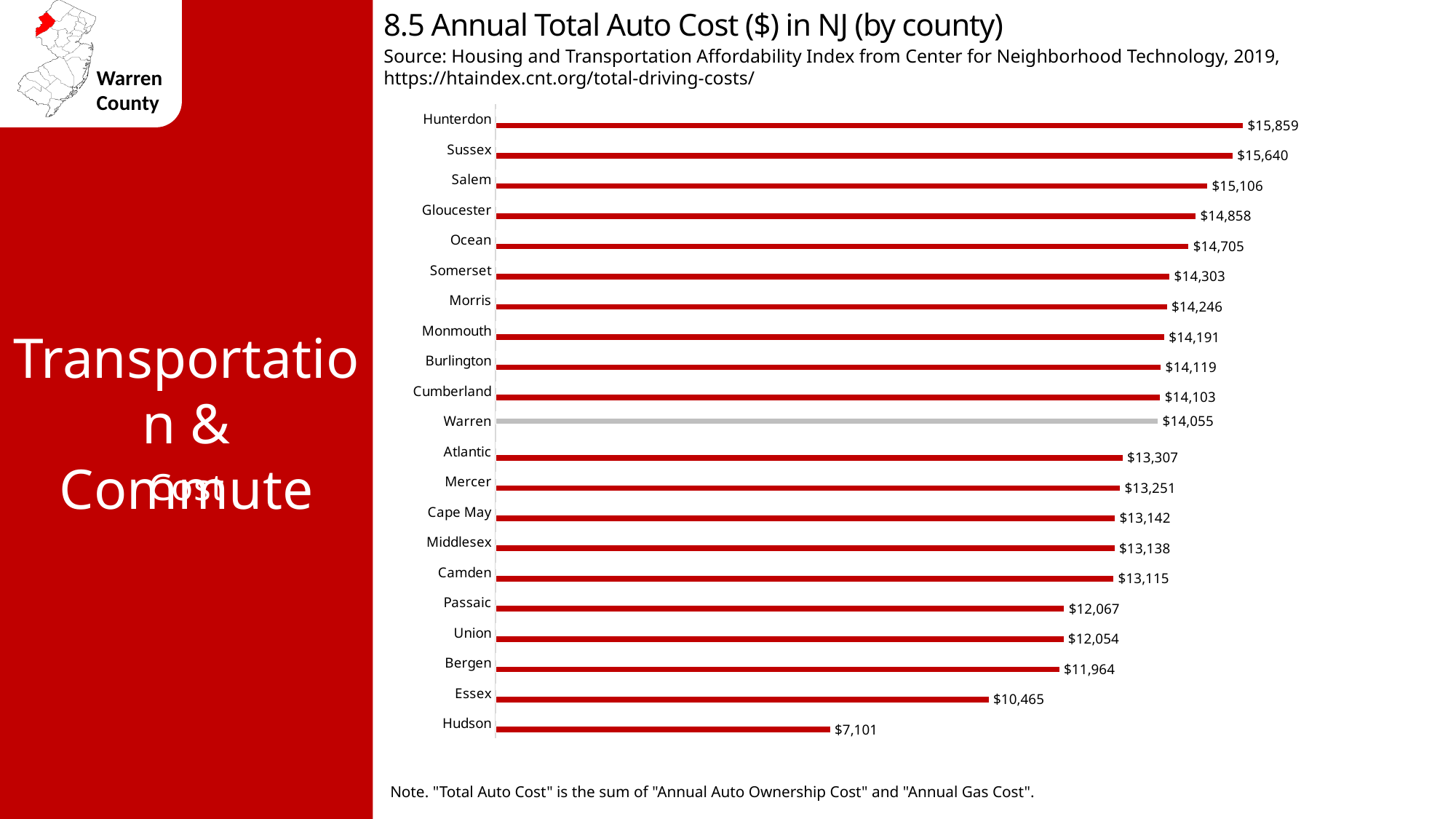
What is the difference in annual total auto cost between Warren and Hudson? $6,954 Which county has the highest annual total auto cost? Hunterdon Which county has the lowest annual total auto cost? Hudson How many counties are shown in the chart? 21 What is the annual total auto cost for Somerset County? $14,303 Which county has a higher annual total auto cost, Ocean or Gloucester? Gloucester Which county has a higher annual total auto cost, Essex or Bergen? Bergen Which county's bar is shown in grey rather than red? Warren What type of chart is used on this slide? Bar chart What is the annual total auto cost for Hudson County? $7,101 What is the difference in annual total auto cost between Hunterdon and Sussex? $219 What is the annual total auto cost for Warren County? $14,055